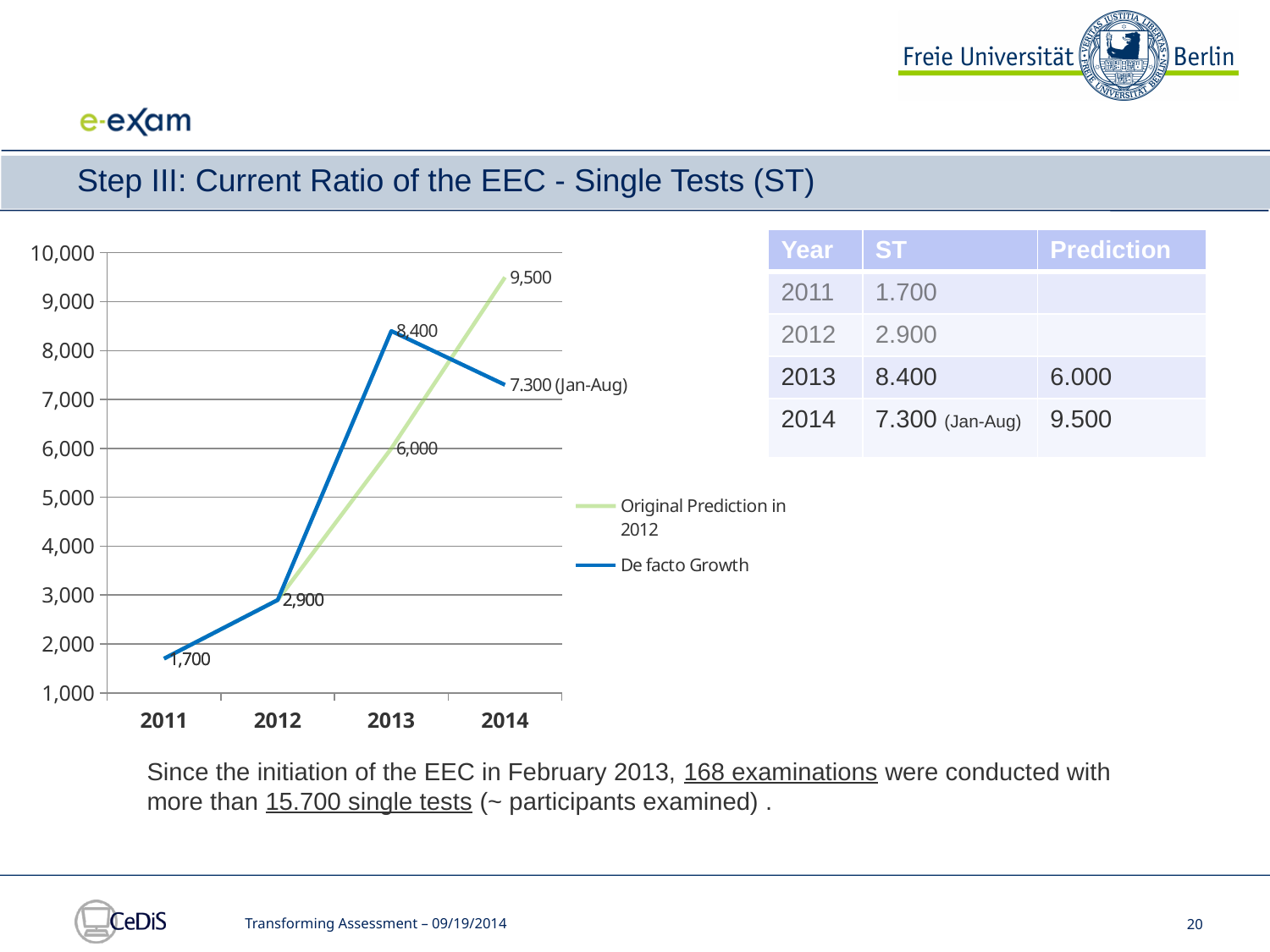
What is the De facto Growth value for 2011? 1,700 What is the Original Prediction in 2012 value for 2013? 6,000 What are the two series named in the chart legend? Original Prediction in 2012; De facto Growth How many years are shown on the x axis of the chart? 4 What is the difference between the De facto Growth value and the Original Prediction in 2012 value for 2013? 2,400 In 2013, which series has the higher value, De facto Growth or Original Prediction in 2012? De facto Growth What is the Original Prediction in 2012 value for 2014? 9,500 What kind of chart is shown on the slide? line chart How many series does the chart legend list? 2 What is the De facto Growth value for 2012? 2,900 Does the De facto Growth line rise or fall between 2013 and 2014? fall What is the De facto Growth value for 2013? 8,400